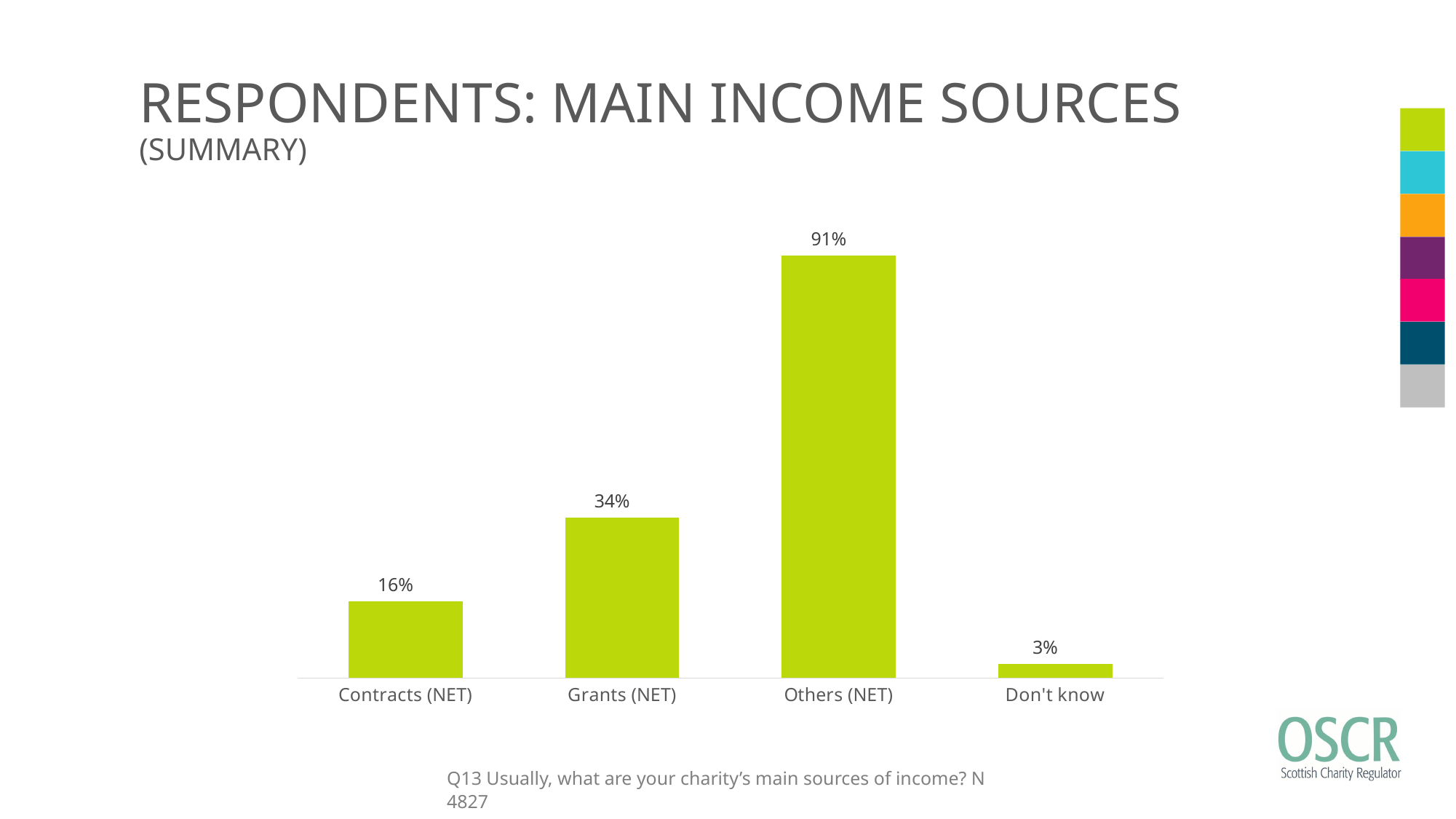
What is the value for Grants (NET)? 34% What is the title of the slide containing the chart? RESPONDENTS: MAIN INCOME SOURCES (SUMMARY) Which category has the highest value? Others (NET) What kind of chart is shown on the slide? Bar chart What is the difference between the values for Others (NET) and Grants (NET)? 57% What is the value for Others (NET)? 91% Which category has the lowest value? Don't know What is the difference between the values for Grants (NET) and Contracts (NET)? 18% How many categories are shown on the chart? 4 Which is larger, the value for Contracts (NET) or the value for Grants (NET)? Grants (NET) What is the value for Contracts (NET)? 16% What is the value for Don't know? 3%